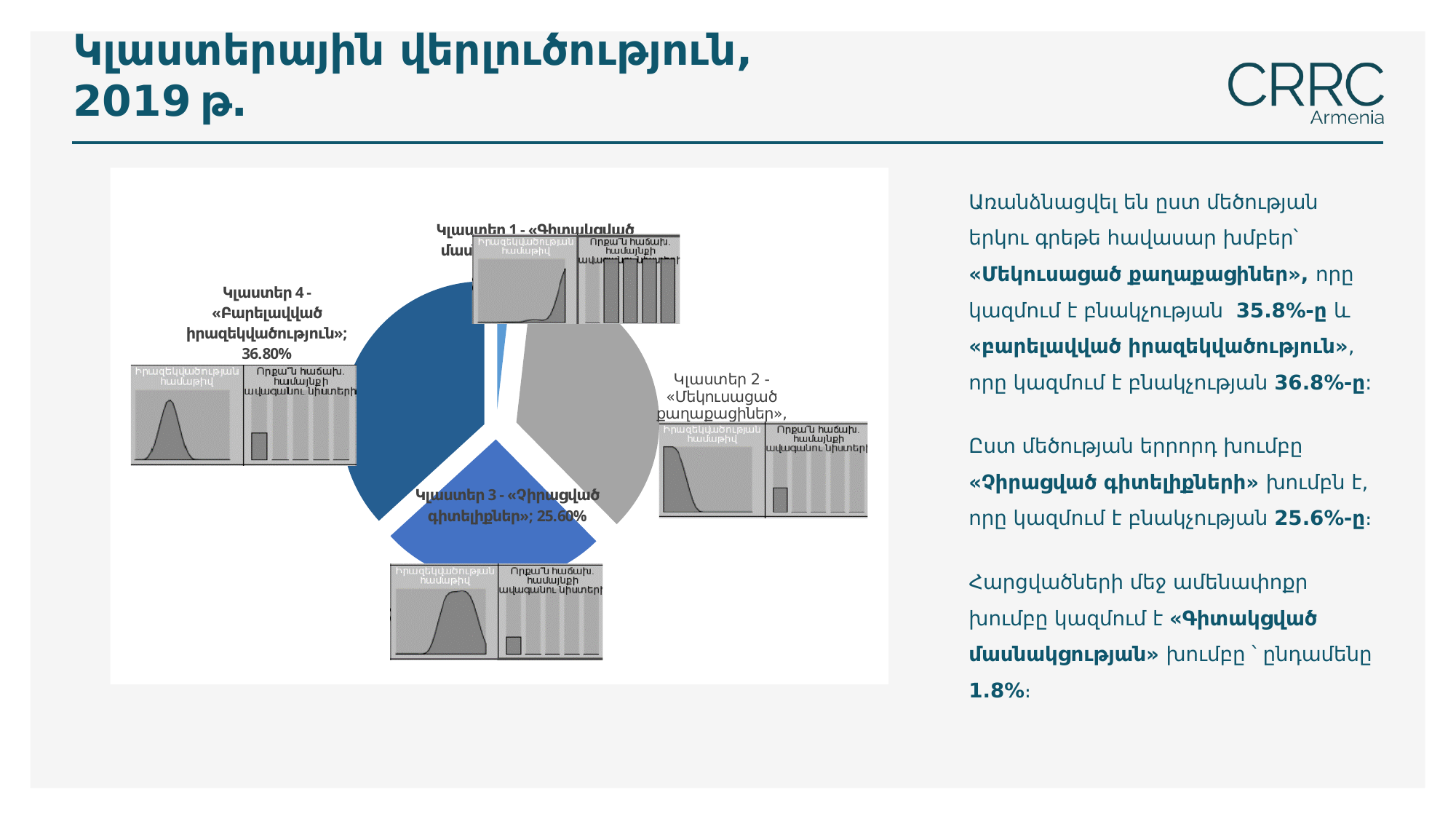
What kind of chart is shown on the slide? pie chart What is the title of the slide containing the pie chart? Կլաստերային վերլուծություն, 2019 թ. According to the slide, what share of the population does the «Գիտակցված մասնակցություն» cluster make up? 1.8% What colour is the slice for Կլաստեր 2 - «Մեկուսացած քաղաքացիներ»? grey How many clusters (slices) does the pie chart show? 4 What share of the pie is labelled for Կլաստեր 3 - «Չիրացված գիտելիքներ»? 25.60% Which cluster has the smallest slice of the pie? Կլաստեր 1 - «Գիտակցված մասնակցություն» Which is larger: the slice for Կլաստեր 3 or the slice for Կլաստեր 4? Կլաստեր 4 What share of the pie is labelled for Կլաստեր 4 - «Բարելավված իրազեկվածություն»? 36.80% What is the difference in percentage points between Կլաստեր 4 (36.80%) and Կլաստեր 3 (25.60%)? 11.20% According to the slide, what share of the population does Կլաստեր 2 - «Մեկուսացած քաղաքացիներ» make up? 35.8% Which cluster has the largest slice of the pie? Կլաստեր 4 - «Բարելավված իրազեկվածություն»